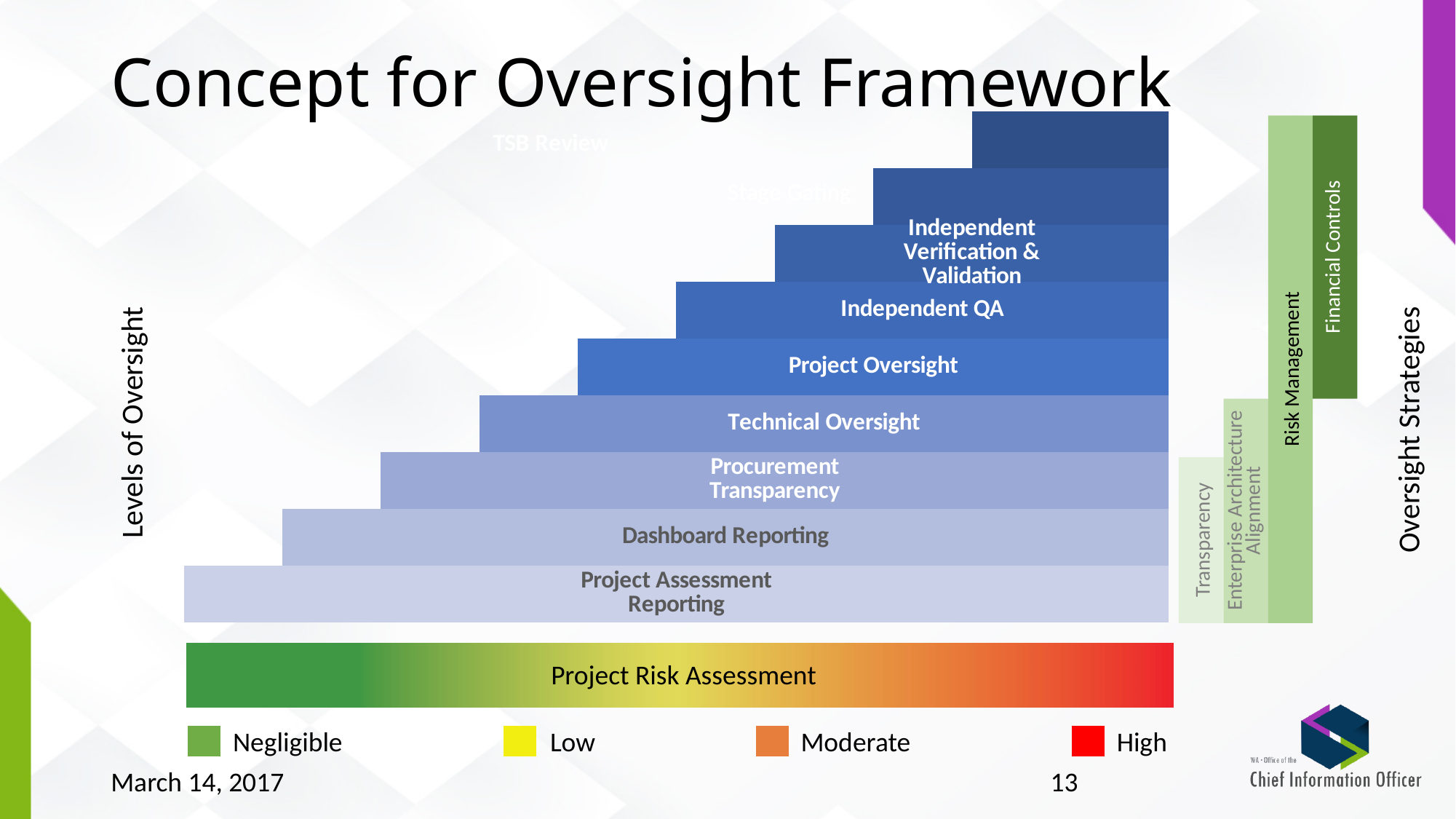
Which Oversight Strategy bar on the right is the shortest? Transparency Which Oversight Strategy bar on the right is the tallest? Risk Management Which step is directly above Dashboard Reporting in the staircase? Procurement Transparency Which risk level in the legend is shown in red? High Which step is directly above Independent QA in the staircase? Independent Verification & Validation What is the label on the vertical axis to the left of the staircase? Levels of Oversight How many Oversight Strategies bars are shown on the right side of the diagram? 4 How many risk levels are listed in the legend below the Project Risk Assessment bar? 4 What label is on the lowest step of the staircase diagram? Project Assessment Reporting